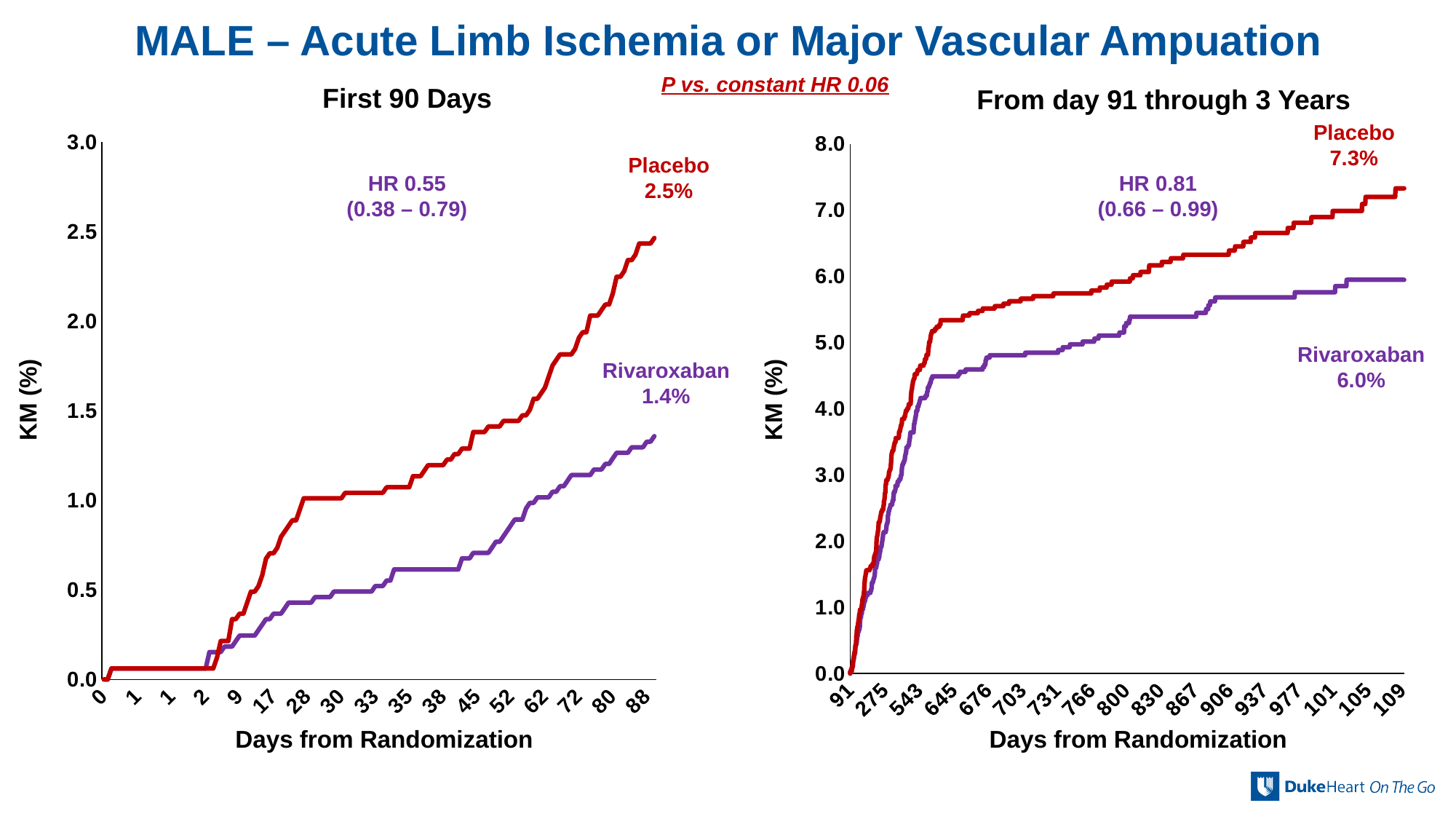
In the 'From day 91 through 3 Years' chart, what is the final KM (%) value labelled for Rivaroxaban? 6.0% What hazard ratio is shown on the 'From day 91 through 3 Years' chart? HR 0.81 (0.66 – 0.99) How many treatment groups are plotted in the 'First 90 Days' chart? 2 In the 'First 90 Days' chart, is the Rivaroxaban value at day 88 greater or less than 1.5? less What kind of chart is the 'From day 91 through 3 Years' chart? Line chart In the 'From day 91 through 3 Years' chart, what is the final KM (%) value labelled for Placebo? 7.3% In the 'First 90 Days' chart, what is the final KM (%) value labelled for Rivaroxaban? 1.4% In the 'First 90 Days' chart, what is the difference between the labelled Placebo and Rivaroxaban values? 1.1% In the 'First 90 Days' chart, which group has the higher final KM (%) value, Placebo or Rivaroxaban? Placebo In the 'First 90 Days' chart, do the KM (%) values rise or fall as days from randomization increase? Rise In the 'First 90 Days' chart, what is the final KM (%) value labelled for Placebo? 2.5% In the 'From day 91 through 3 Years' chart, what is the difference between the labelled Placebo and Rivaroxaban values? 1.3%